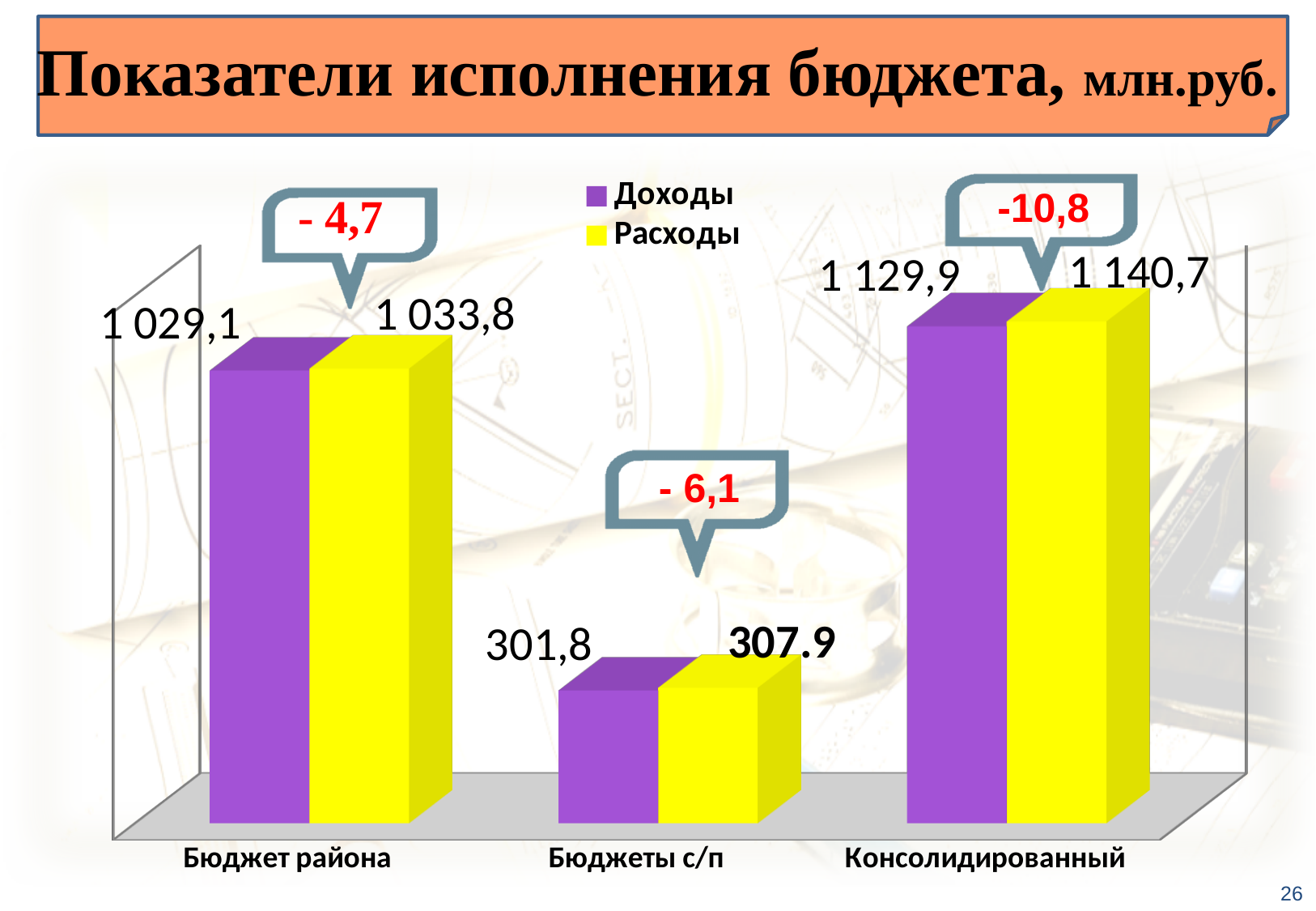
What is the value of Расходы for Консолидированный? 1 140,7 Which category has the lowest Доходы value? Бюджеты с/п What is the value of Доходы for Бюджет района? 1 029,1 What is the difference between Расходы and Доходы for Консолидированный? 10,8 What colour represents Доходы in the chart? Purple How many categories are shown on the x axis? 3 What is the value of Расходы for Бюджет района? 1 033,8 Which category has the highest Расходы value? Консолидированный What is the value of Доходы for Бюджеты с/п? 301,8 How many series does the legend list? 2 For Бюджеты с/п, which is larger: Доходы or Расходы? Расходы What type of chart is shown on the slide? Bar chart